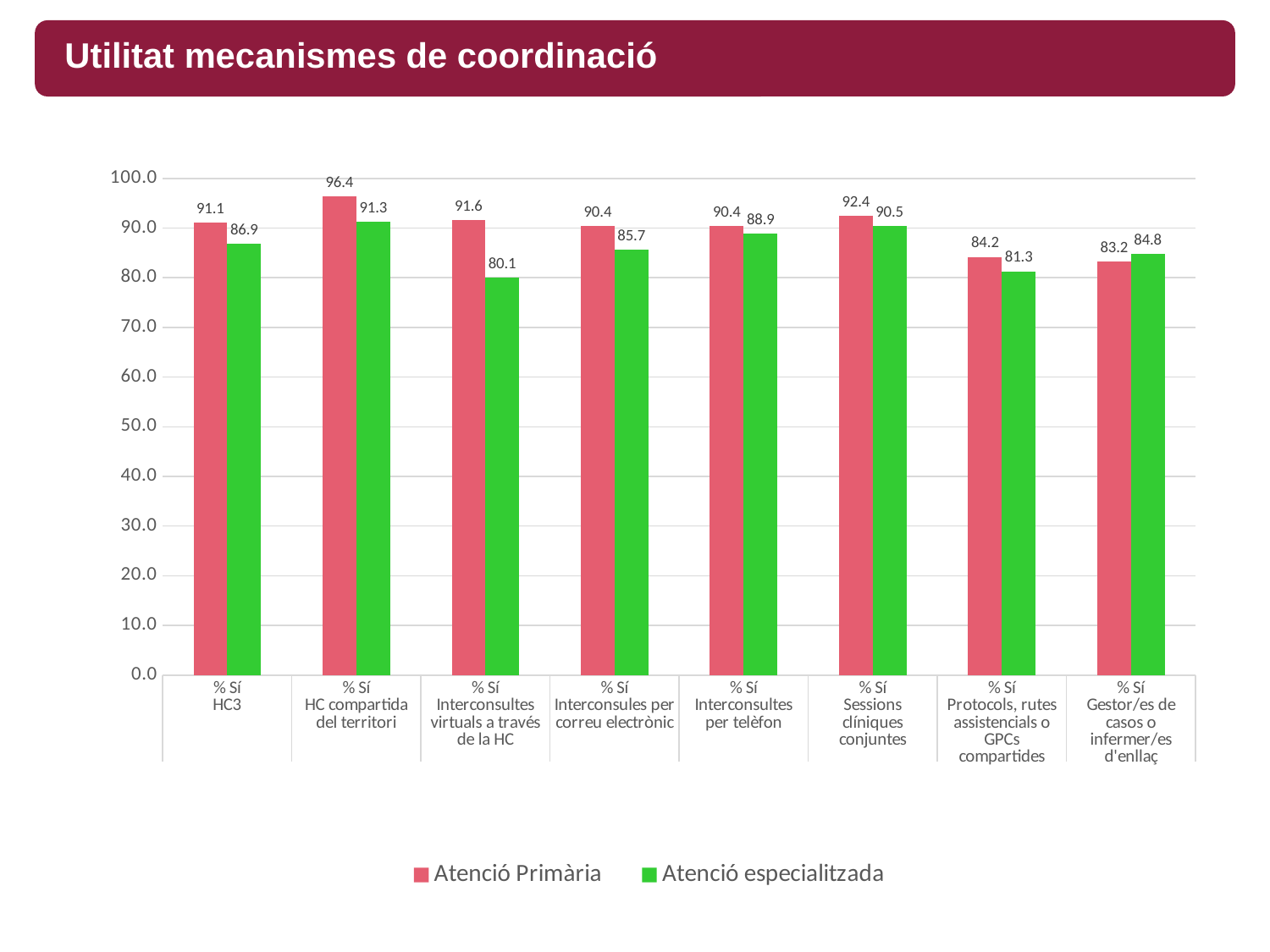
Which is larger for Gestor/es de casos o infermer/es d'enllaç: Atenció Primària or Atenció especialitzada? Atenció especialitzada What is the value for Atenció especialitzada for Gestor/es de casos o infermer/es d'enllaç? 84.8 What is the title of the slide? Utilitat mecanismes de coordinació Which category has the highest value for Atenció Primària? HC compartida del territori What is the difference between Atenció Primària and Atenció especialitzada for Interconsultes virtuals a través de la HC? 11.5 What kind of chart is shown on the slide? Bar chart How many categories are shown on the x axis? 8 How many series does the legend list? 2 Is the value for Atenció especialitzada for Protocols, rutes assistencials o GPCs compartides greater or less than 90.0? less Which category has the lowest value for Atenció especialitzada? Interconsultes virtuals a través de la HC What is the value for Atenció Primària for HC3? 91.1 What is the value for Atenció especialitzada for Interconsultes virtuals a través de la HC? 80.1